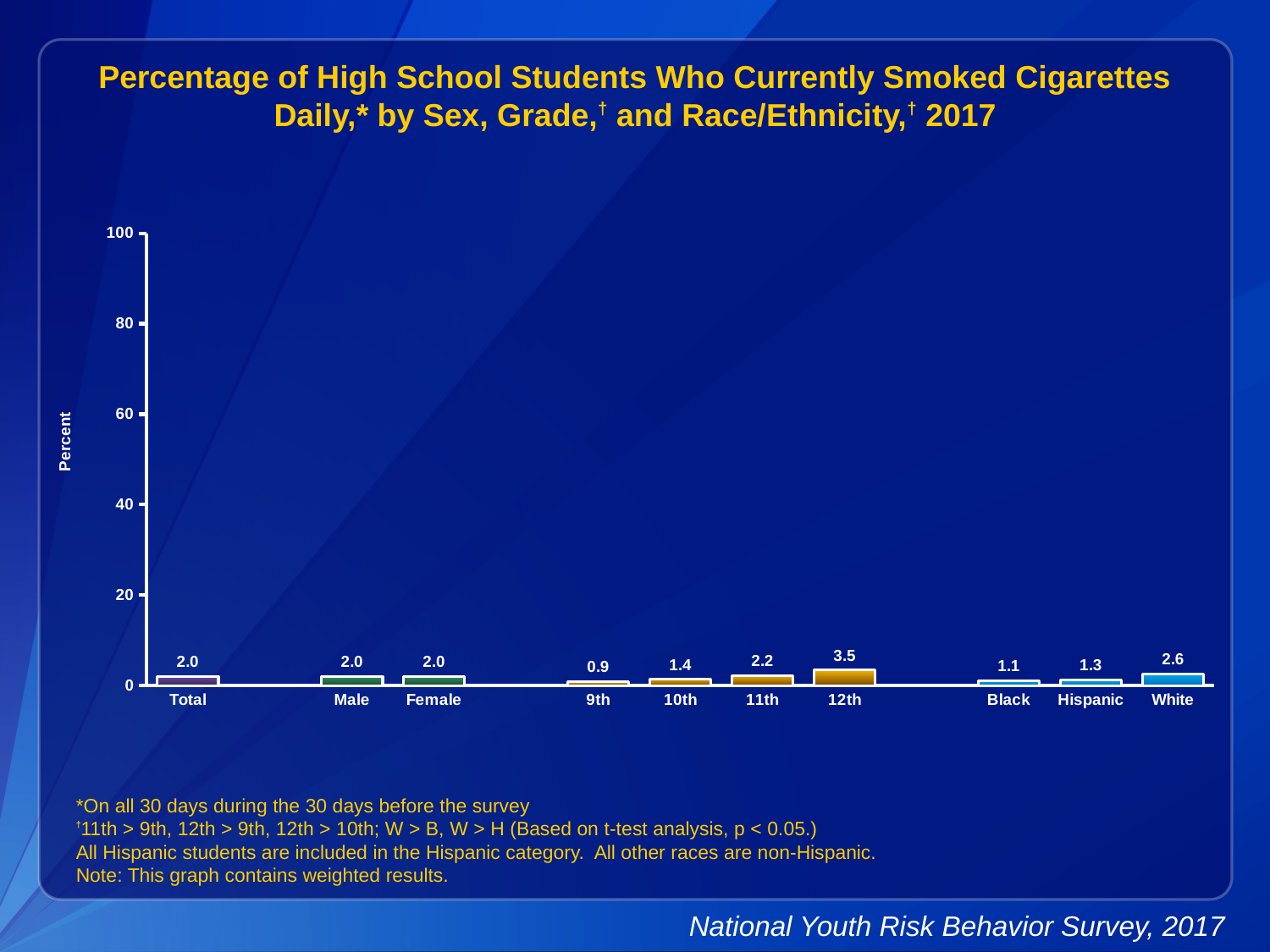
What kind of chart is this? bar chart What is the value for Total? 2.0 What is the value for Hispanic students? 1.3 Which is larger, the value for 11th grade or the value for 10th grade? 11th Which category has the highest value? 12th What is the difference between the values for White and Black students? 1.5 How many categories are shown on the x axis? 10 What is the value for 9th grade? 0.9 What is the value for 12th grade? 3.5 What is the difference between the values for 12th grade and 9th grade? 2.6 Is the value for White students greater or less than 20? less Which category has the lowest value? 9th